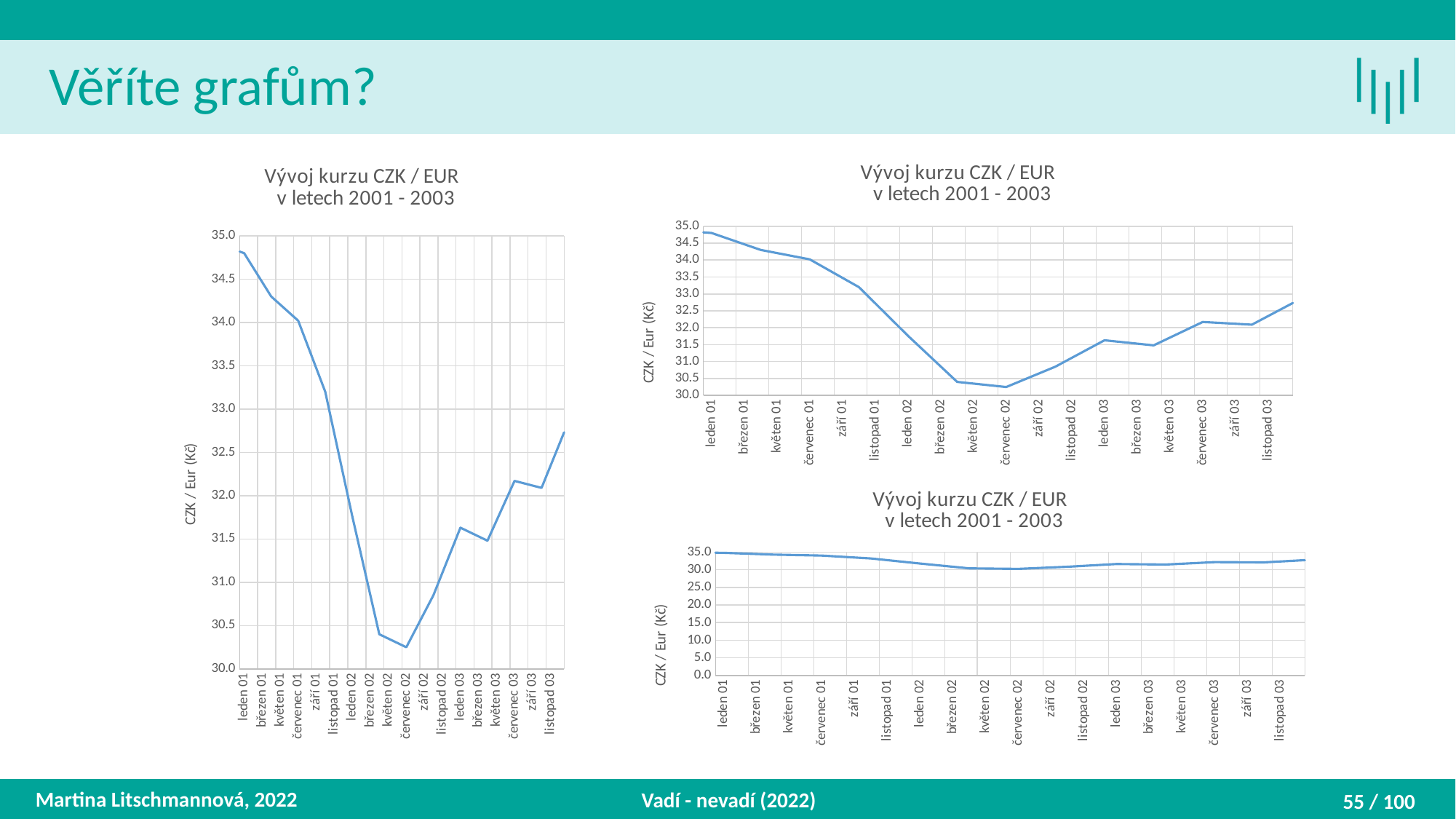
What is the y-axis label of the bottom-right chart? CZK / Eur (Kč) In the chart on the left, which month has the lowest CZK / EUR value? červenec 02 In the top-right chart, is the value for listopad 03 greater or less than 32.5? greater In the chart on the left, which month has the highest CZK / EUR value? leden 01 In the chart on the left, do the values rise or fall from leden 01 to červenec 02? fall What type of chart is the chart on the left side of the slide? line chart In the chart on the left, is the value for leden 01 greater or less than 34.5? greater In the chart on the left, is the value for červenec 02 greater or less than 30.5? less How many charts are shown on the slide? 3 In the chart on the left, which is larger, the value for leden 01 or the value for listopad 03? leden 01